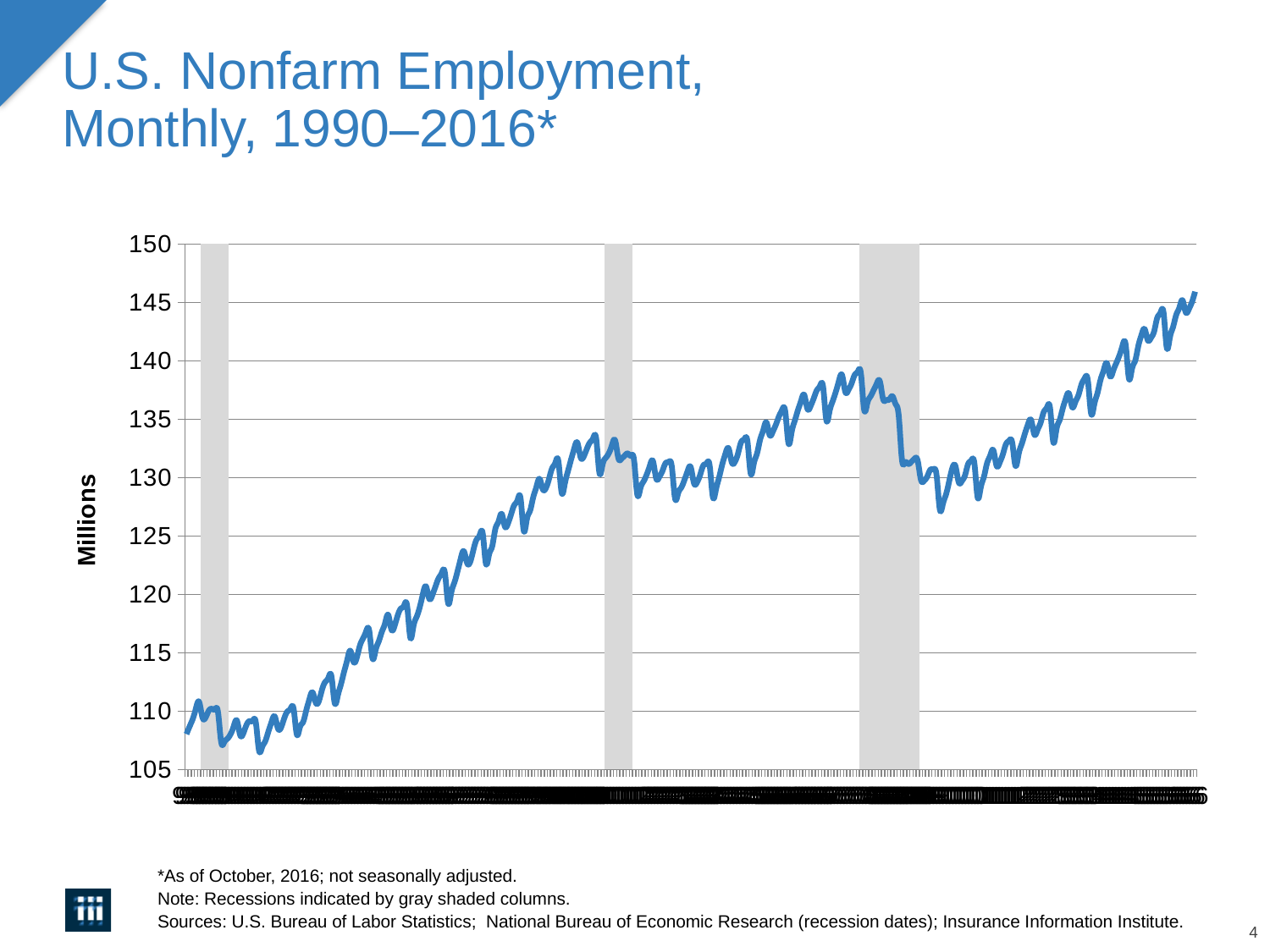
What kind of chart is shown on the slide? line chart Is the peak before the third gray shaded column higher or lower than the peak before the second gray shaded column? higher Is the value at the start of the series greater or less than 110? less Overall, does U.S. nonfarm employment rise or fall from the start of the series to the end? rise Does the line rise or fall during the third gray shaded column? fall How many gray shaded recession columns are shown on the chart? 3 Is the lowest point on the line greater or less than 110? less Is the low point reached after the third gray shaded column greater or less than 130? less What is the label on the vertical axis? Millions Is the value at the end of the series higher or lower than the value at the start of the series? higher